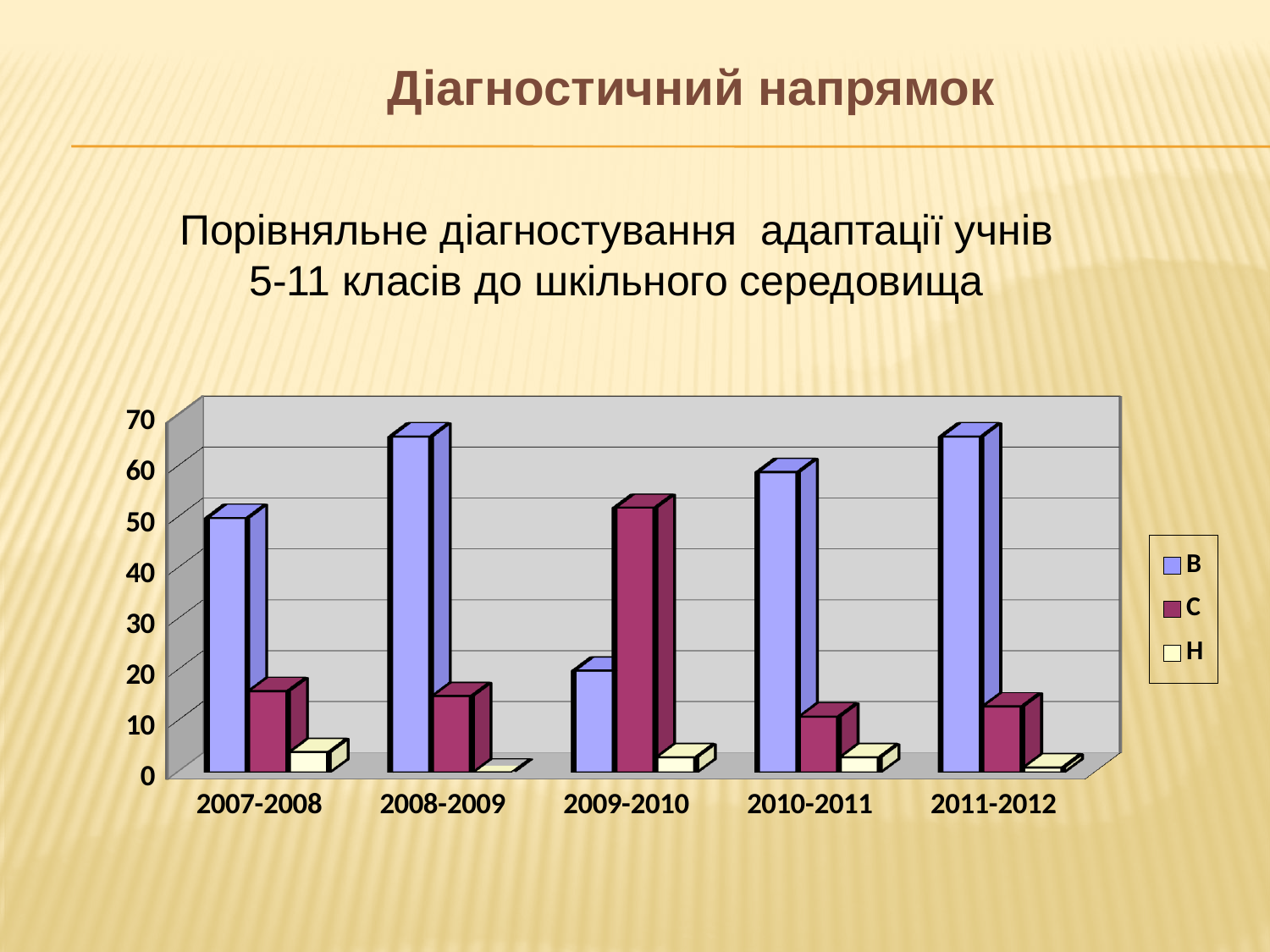
Is the value for В in 2009-2010 greater or less than 30? less In 2009-2010, which series has the larger value, В or С? С Which category has the lowest value for series В? 2009-2010 Which category has the highest value for series С? 2009-2010 Is the value for Н in 2007-2008 greater or less than 10? less Is the value for В in 2008-2009 greater or less than 60? greater Which is larger: the value for В in 2007-2008 or the value for В in 2009-2010? 2007-2008 What are the legend entries of the chart? В, С, Н What kind of chart is shown on the slide? bar chart How many series does the legend list? 3 How many school-year categories are shown on the x axis? 5